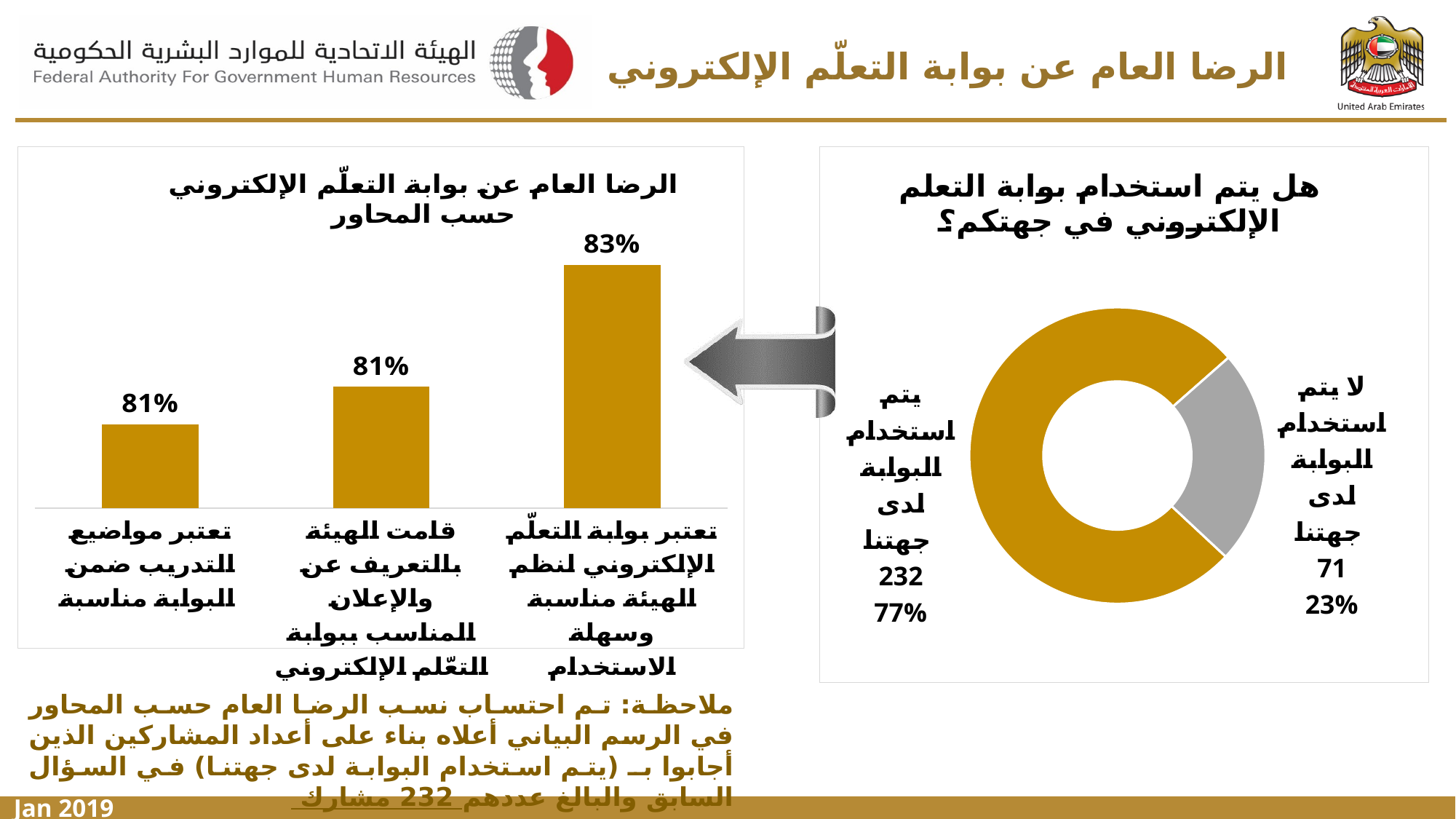
What is the title of the chart on the right? هل يتم استخدام بوابة التعلم الإلكتروني في جهتكم؟ In the donut chart on the right, which answer has the larger share: "يتم استخدام البوابة لدى جهتنا" or "لا يتم استخدام البوابة لدى جهتنا"? يتم استخدام البوابة لدى جهتنا In the bar chart on the left, what is the difference between the highest value and the value for "تعتبر مواضيع التدريب ضمن البوابة مناسبة"? 2% In the donut chart on the right, what percentage of respondents answered "يتم استخدام البوابة لدى جهتنا"? 77% How many bars are in the bar chart on the left? 3 In the bar chart on the left, what is the value for "تعتبر مواضيع التدريب ضمن البوابة مناسبة"? 81% What type of chart is the chart on the left? Bar chart In the bar chart on the left, what is the value for "قامت الهيئة بالتعريف عن والإعلان المناسب ببوابة التعّلم الإلكتروني"? 81% In the donut chart on the right, how many respondents answered "لا يتم استخدام البوابة لدى جهتنا"? 71 In the donut chart on the right, how many respondents answered "يتم استخدام البوابة لدى جهتنا"? 232 In the bar chart on the left, which category has the highest value? تعتبر بوابة التعلّم الإلكتروني لنظم الهيئة مناسبة وسهلة الاستخدام In the bar chart on the left, what is the value for "تعتبر بوابة التعلّم الإلكتروني لنظم الهيئة مناسبة وسهلة الاستخدام"? 83%